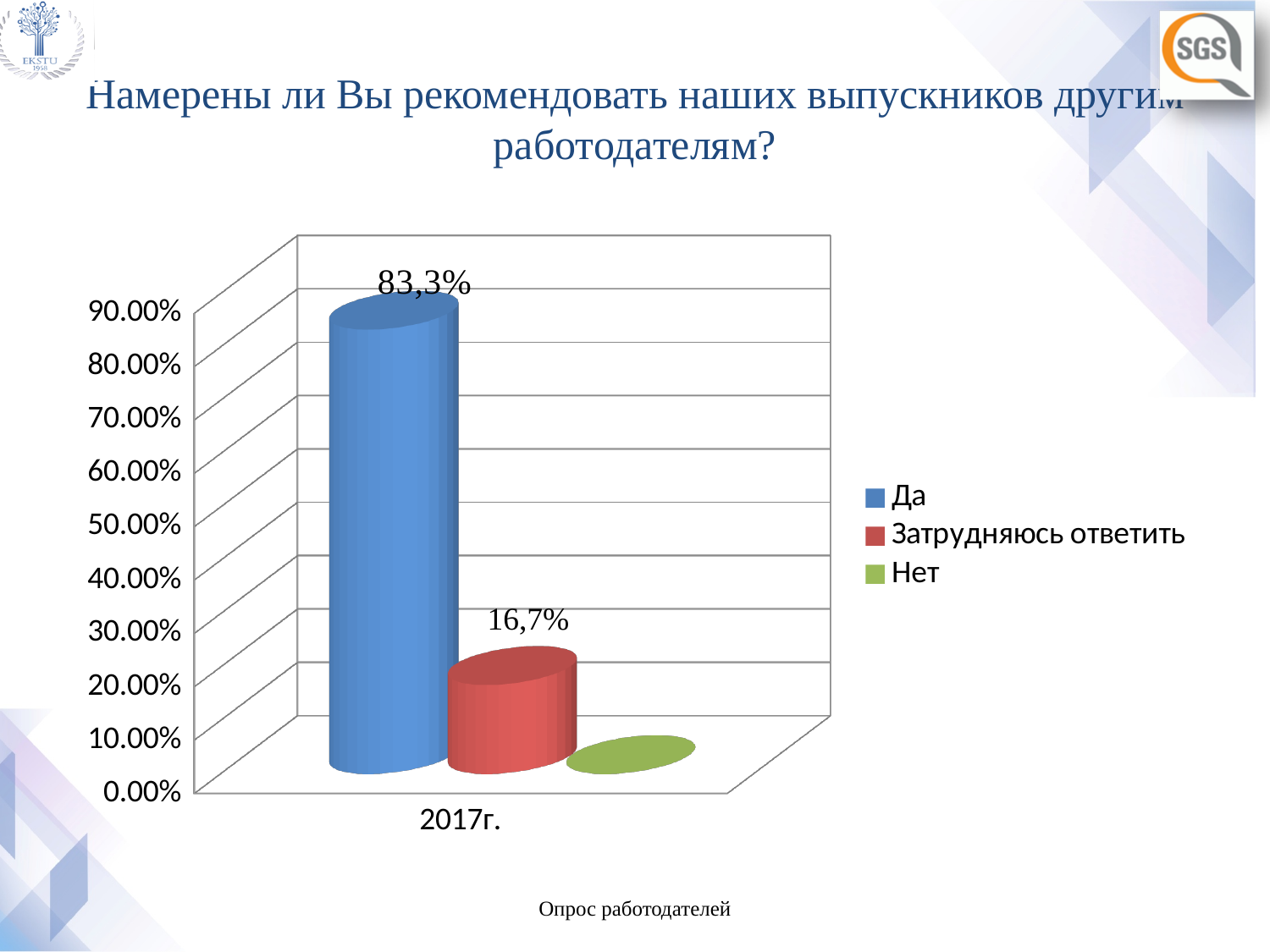
What colour is the bar for Да? blue What is the value for Да in 2017г.? 83,3% How many series does the legend list? 3 Which response has the highest value? Да Which is larger, the value for Да or the value for Затрудняюсь ответить? Да Is the value for Затрудняюсь ответить greater or less than 20.00%? less How many categories are shown on the x axis? 1 What is the value for Затрудняюсь ответить in 2017г.? 16,7% What kind of chart is shown on the slide? bar chart Is the value for Да greater or less than 80.00%? greater What is the difference between the values for Да and Затрудняюсь ответить? 66,6% Which response has the lowest value? Нет